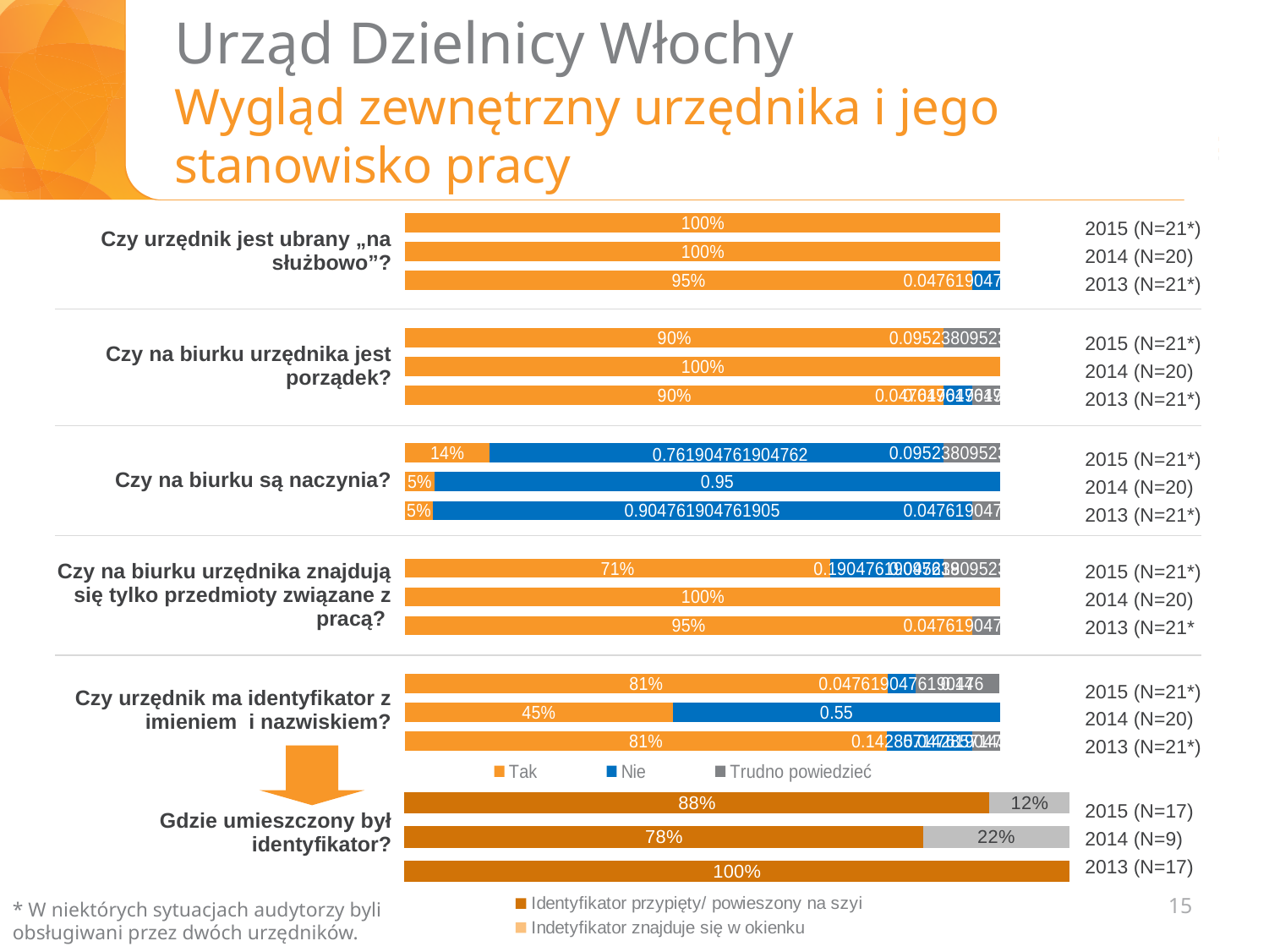
In the chart "Czy na biurku są naczynia?", what is the "Tak" value for 2015 (N=21*)? 14% In the chart "Gdzie umieszczony był identyfikator?", which year has the highest "Identyfikator przypięty/ powieszony na szyi" value? 2013 (N=17) In the chart "Czy na biurku urzędnika jest porządek?", what is the "Tak" value for 2015 (N=21*)? 90% In the chart "Czy urzędnik jest ubrany „na służbowo”?", what is the "Tak" value for 2013 (N=21*)? 95% In the chart "Gdzie umieszczony był identyfikator?", what is the value for "Identyfikator przypięty/ powieszony na szyi" in 2014 (N=9)? 78% What kind of chart is used for "Czy na biurku są naczynia?"? Stacked bar chart In the chart "Czy urzędnik ma identyfikator z imieniem i nazwiskiem?", what is the "Nie" value for 2014 (N=20)? 0.55 In the chart "Czy urzędnik ma identyfikator z imieniem i nazwiskiem?", which year has the lowest "Tak" value? 2014 (N=20) How many series does the legend of the chart "Gdzie umieszczony był identyfikator?" list? 2 In the chart "Czy na biurku są naczynia?", what is the "Nie" value for 2014 (N=20)? 0.95 In the chart "Gdzie umieszczony był identyfikator?", what is the difference between the "Identyfikator przypięty/ powieszony na szyi" values for 2015 (N=17) and 2014 (N=9)? 10 percentage points In the chart "Czy na biurku urzędnika znajdują się tylko przedmioty związane z pracą?", what is the "Tak" value for 2015 (N=21*)? 71%